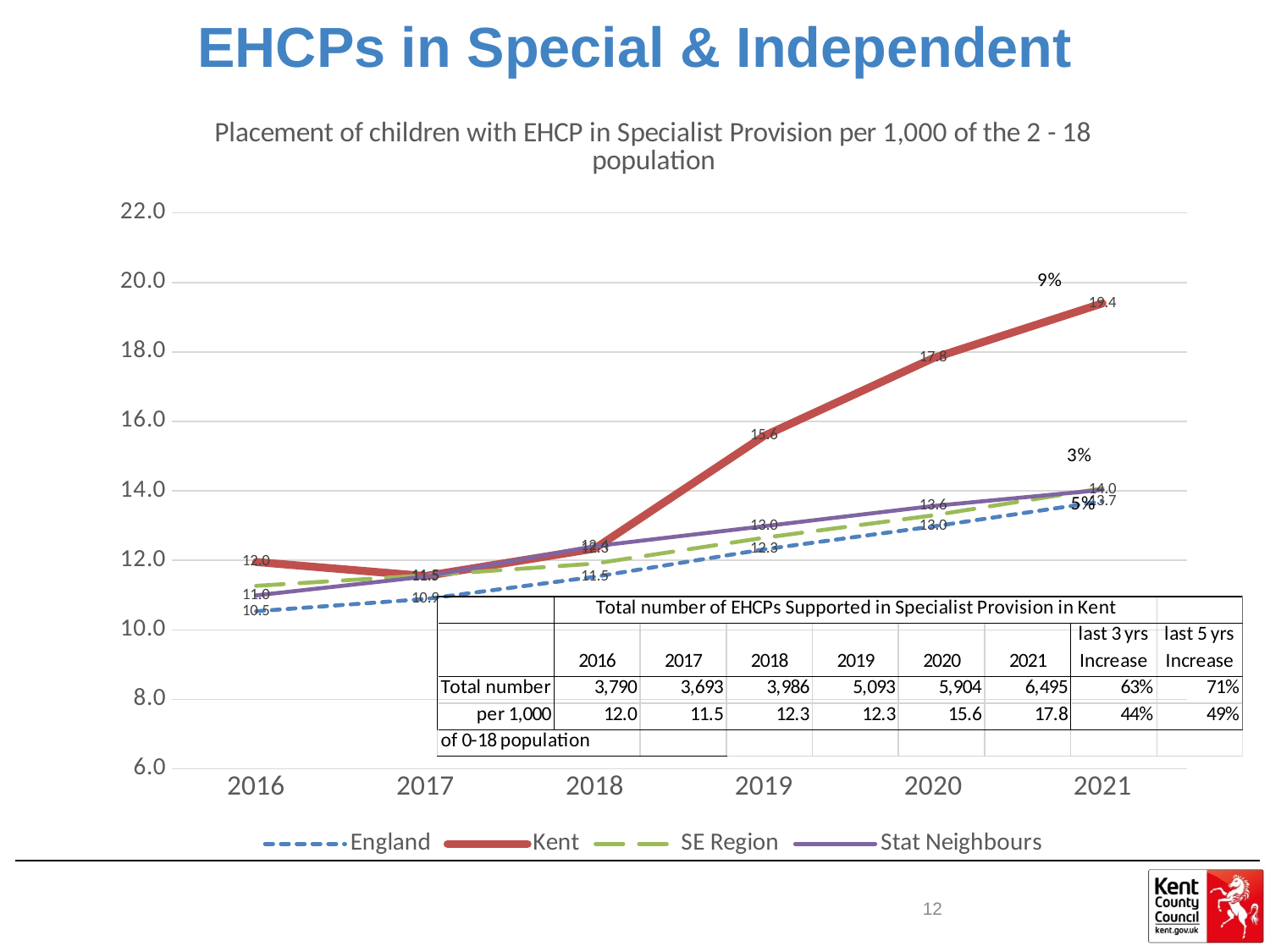
How many years are shown along the x axis of the chart? 6 What is the value for Kent in 2020? 17.8 Which series has the lowest value in 2016? England Is the value for Kent in 2021 greater or less than 18.0? greater What is the difference between Kent's value in 2021 and its value in 2020? 1.6 Does the Kent line rise or fall between 2018 and 2021? rise In the table on the slide, what is the total number of EHCPs supported in specialist provision in Kent in 2021? 6,495 Which series has the highest value in 2021? Kent What is the value for England in 2016? 10.5 What type of chart is shown on the slide? line chart What is the value for Kent in 2021? 19.4 How many series does the chart legend list? 4